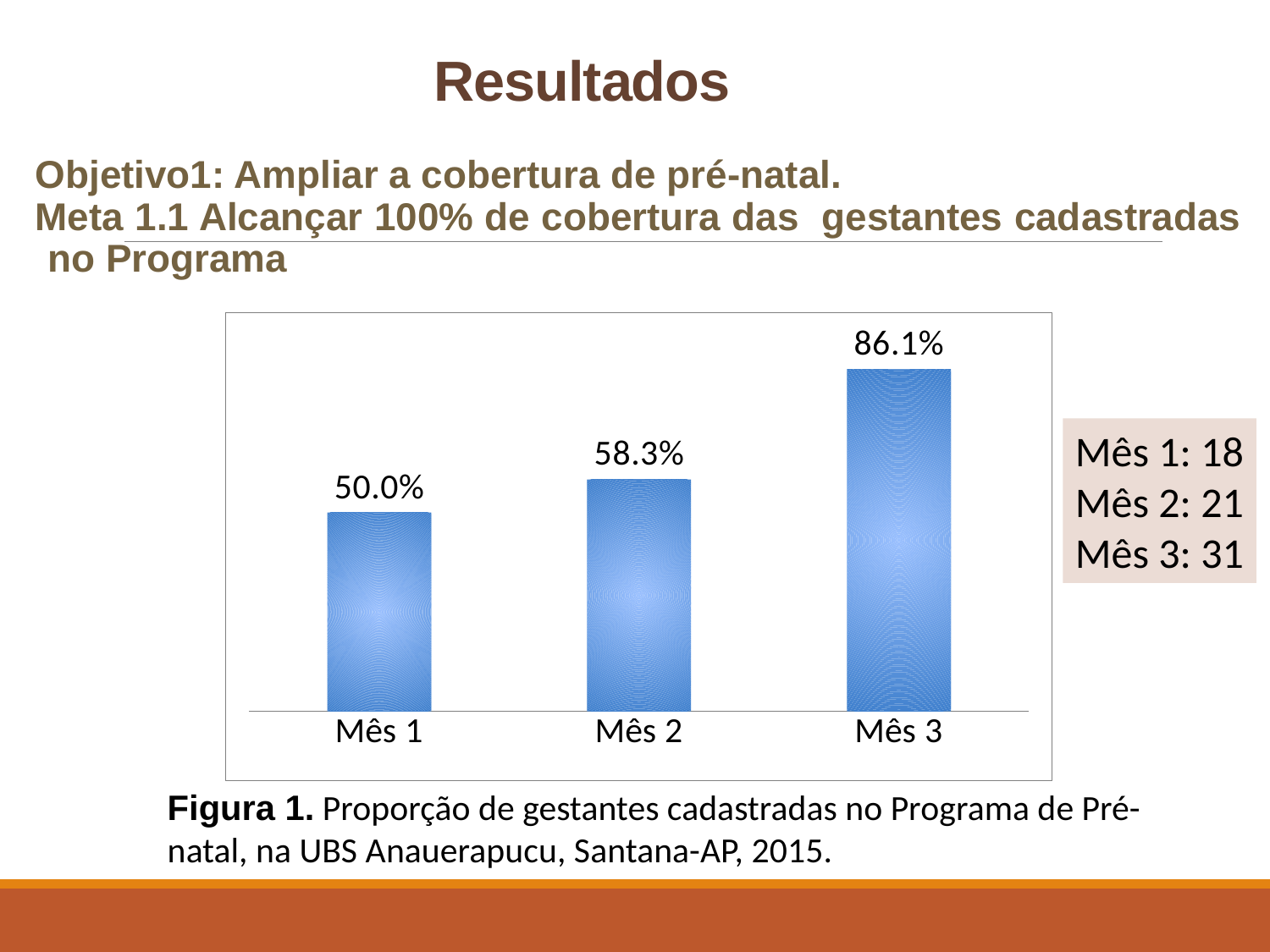
How many categories are shown on the x axis? 3 What is the value for Mês 3? 86.1% Which month has the highest value? Mês 3 What is the value for Mês 1? 50.0% What is the difference between the values for Mês 3 and Mês 1? 36.1% What kind of chart is shown? Bar chart Do the values rise or fall from Mês 1 to Mês 3? Rise What is the value for Mês 2? 58.3% According to the text box beside the chart, how many gestantes were registered in Mês 3? 31 Which month has the lowest value? Mês 1 What is the difference between the values for Mês 2 and Mês 1? 8.3% Which is larger, the value for Mês 2 or the value for Mês 3? Mês 3